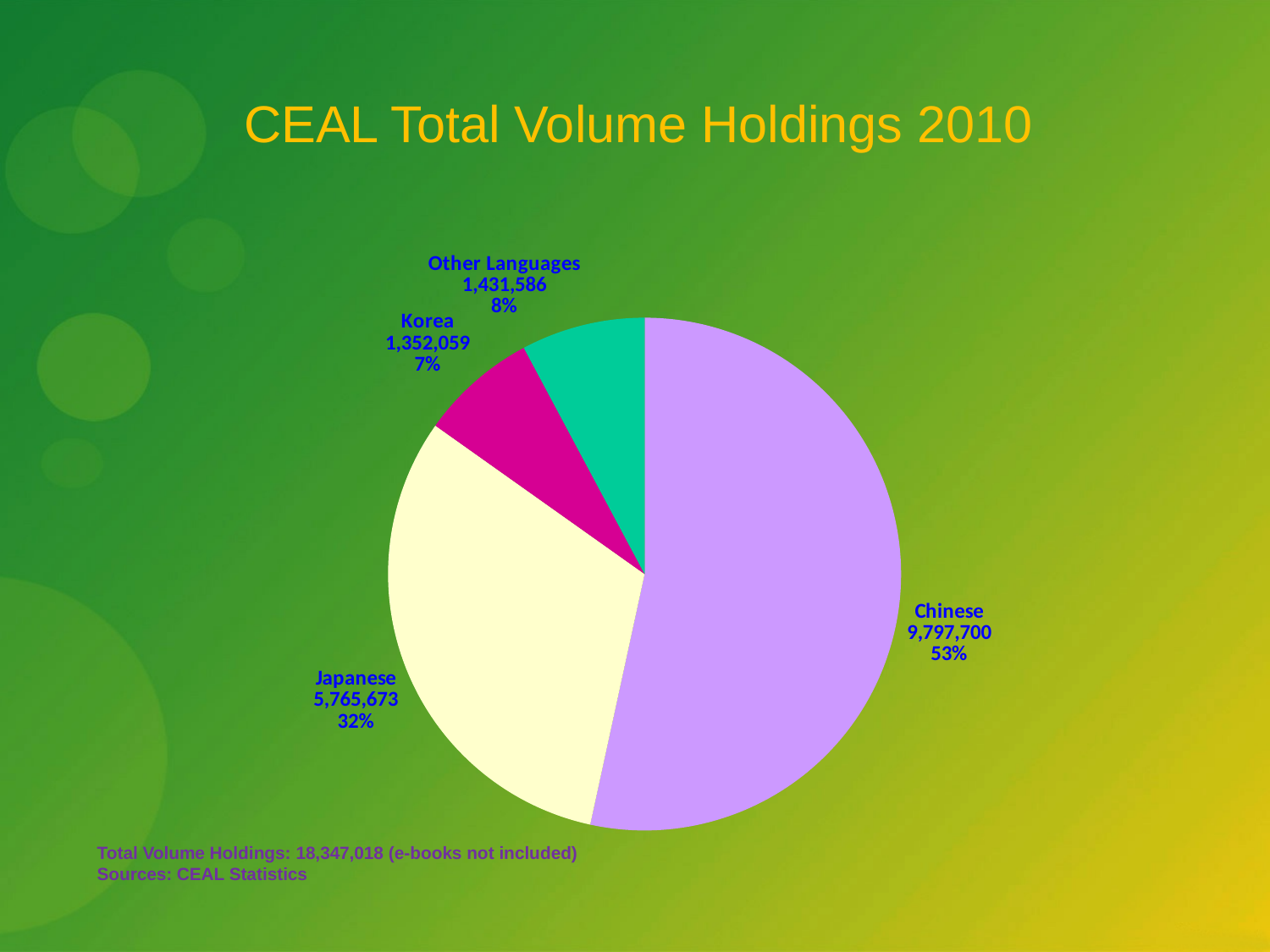
Which language has the largest share of the pie? Chinese What percentage share of the pie does Japanese have? 32% What is the volume holdings value for Chinese? 9,797,700 What type of chart is shown on the slide? pie chart What is the volume holdings value for Korea? 1,352,059 Which language has the smallest share of the pie? Korea How many slices does the pie chart have? 4 What is the difference between the Chinese and Japanese volume holdings? 4,032,027 What is the volume holdings value for Other Languages? 1,431,586 What is the volume holdings value for Japanese? 5,765,673 What percentage share of the pie does Other Languages have? 8% Which is larger, the value for Other Languages or the value for Korea? Other Languages